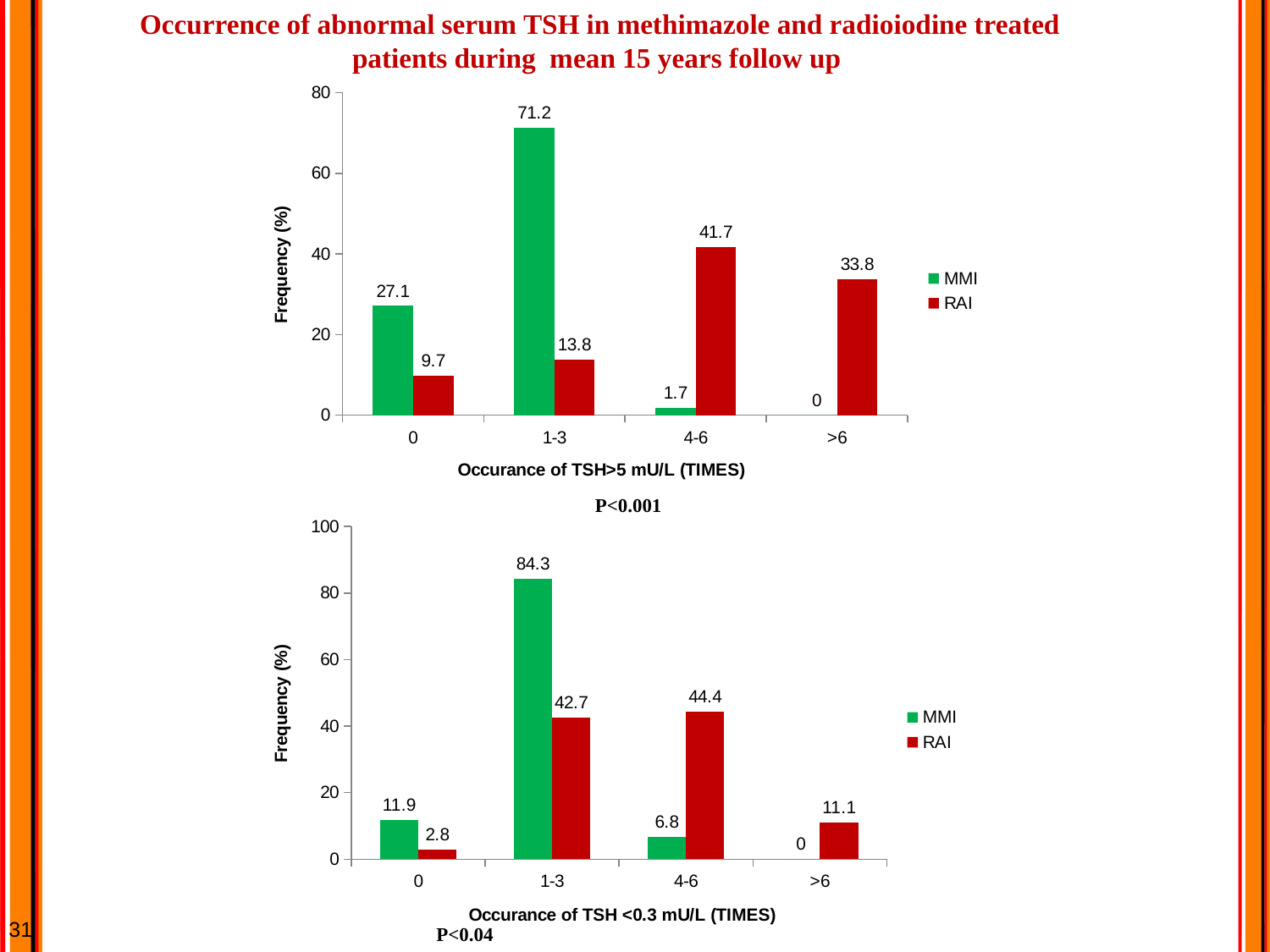
How many categories are shown on the x axis of the top chart (Occurance of TSH>5 mU/L)? 4 How many series does the legend of the bottom chart (Occurance of TSH <0.3 mU/L) list? 2 In the bottom chart (Occurance of TSH <0.3 mU/L), which category has the lowest RAI value? 0 In the top chart (Occurance of TSH>5 mU/L), which category has the highest RAI value? 4-6 In the top chart (Occurance of TSH>5 mU/L), what is the MMI value for the 1-3 category? 71.2 In the bottom chart (Occurance of TSH <0.3 mU/L), what is the MMI value for the 0 category? 11.9 In the top chart (Occurance of TSH>5 mU/L), what is the RAI value for the 4-6 category? 41.7 In the bottom chart (Occurance of TSH <0.3 mU/L), what is the RAI value for the >6 category? 11.1 In the bottom chart (Occurance of TSH <0.3 mU/L), which is larger for the 1-3 category, MMI or RAI? MMI In the top chart (Occurance of TSH>5 mU/L), what is the difference between the MMI and RAI values for the 0 category? 17.4 In the bottom chart (Occurance of TSH <0.3 mU/L), what is the y-axis label? Frequency (%) What kind of chart is the top chart (Occurance of TSH>5 mU/L)? Bar chart